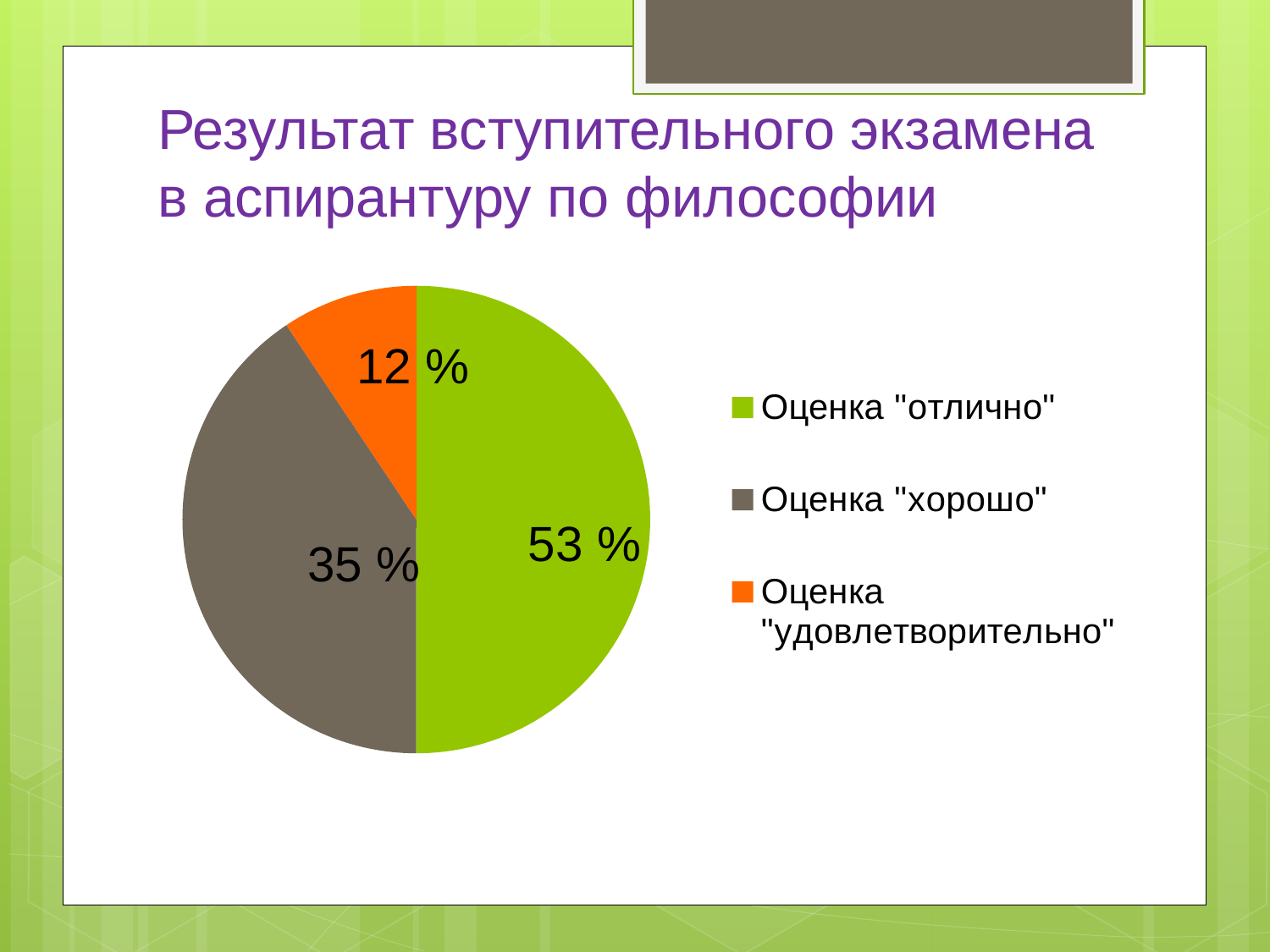
What share of the pie is labelled Оценка "хорошо"? 35 % Which is larger: the Оценка "хорошо" slice or the Оценка "удовлетворительно" slice? Оценка "хорошо" What kind of chart is shown on the slide? pie chart Which grade category has the largest slice of the pie? Оценка "отлично" What share of the pie is labelled Оценка "отлично"? 53 % How many slices does the pie chart have? 3 What is the difference in percentage points between the Оценка "отлично" slice and the Оценка "хорошо" slice? 18 % Which grade category has the smallest slice of the pie? Оценка "удовлетворительно" What colour is the slice for Оценка "удовлетворительно"? orange What share of the pie is labelled Оценка "удовлетворительно"? 12 % What is the title of the chart on the slide? Результат вступительного экзамена в аспирантуру по философии What is the difference in percentage points between the Оценка "хорошо" slice and the Оценка "удовлетворительно" slice? 23 %